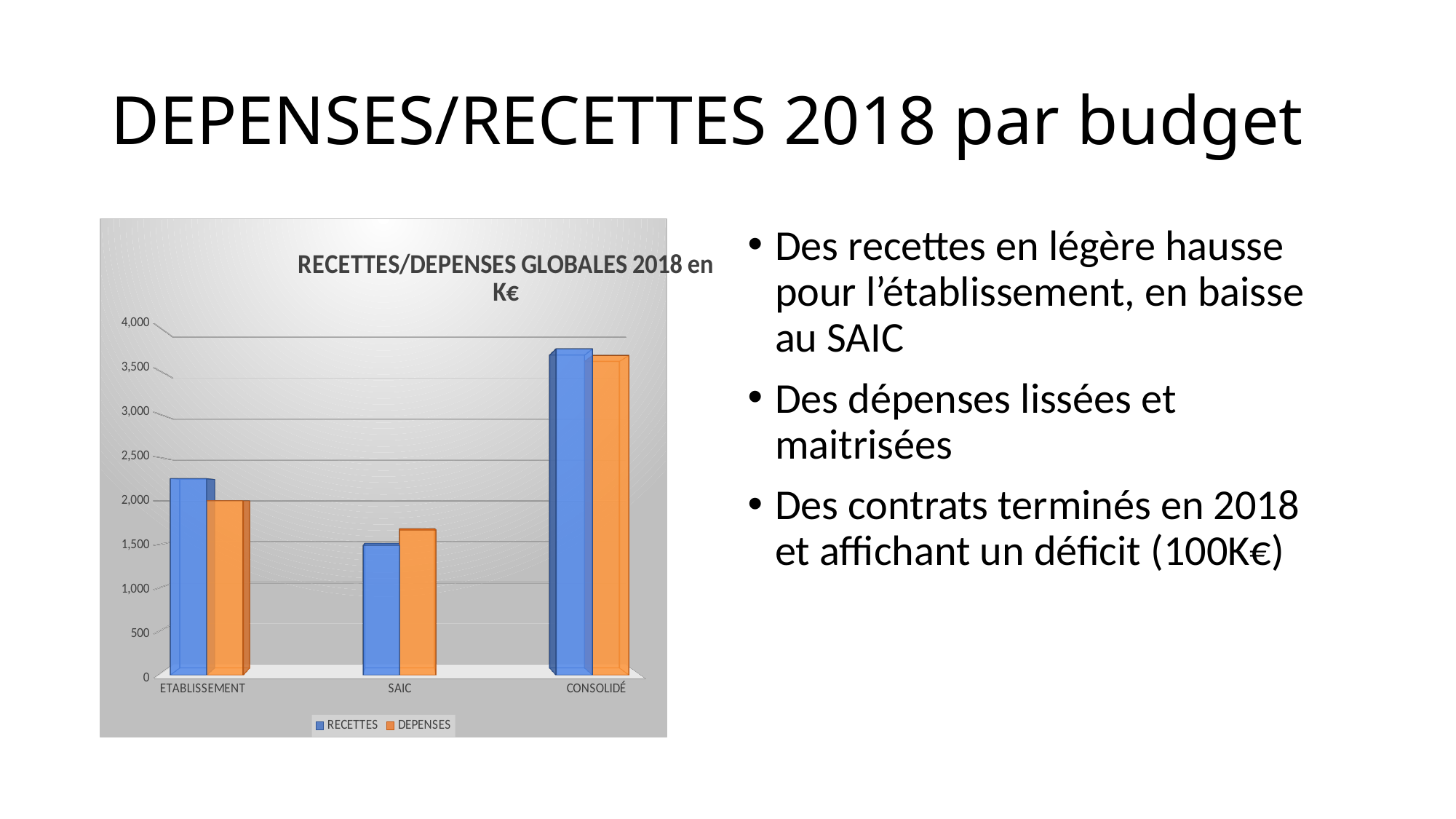
Is the RECETTES value for ETABLISSEMENT greater or less than 2,000? greater What kind of chart is shown on the slide? bar chart For SAIC, which is larger, RECETTES or DEPENSES? DEPENSES Is the DEPENSES value for CONSOLIDÉ greater or less than 4,000? less Is the RECETTES value for CONSOLIDÉ greater or less than 3,500? greater What is the title of the chart? RECETTES/DEPENSES GLOBALES 2018 en K€ Which category has the highest RECETTES value? CONSOLIDÉ How many series does the chart legend list? 2 How many categories are shown on the x axis of the chart? 3 For ETABLISSEMENT, which is larger, RECETTES or DEPENSES? RECETTES Which category has the lowest DEPENSES value? SAIC Which colour represents the DEPENSES series in the chart? orange